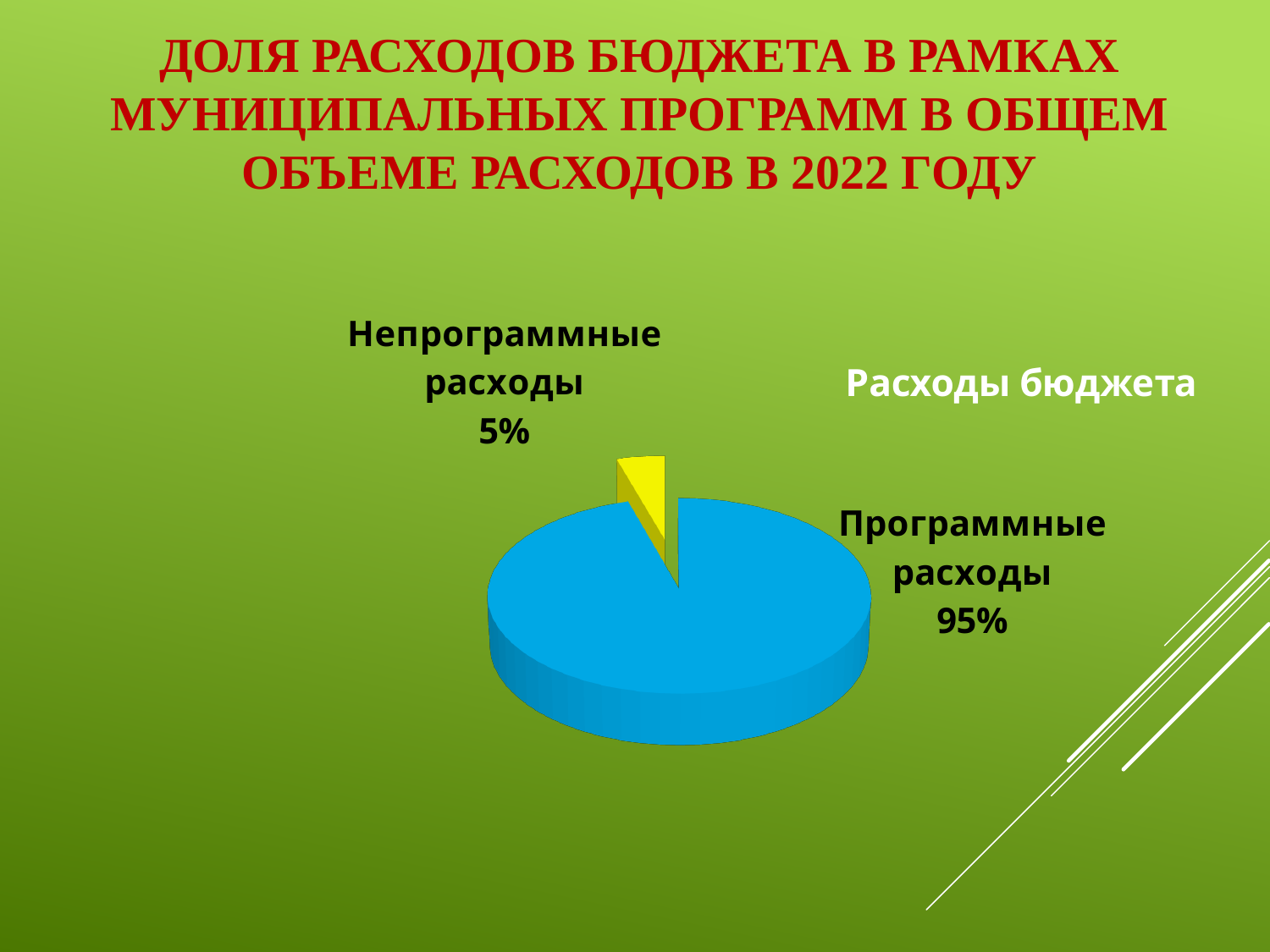
What is the title of the pie chart? Расходы бюджета Which slice of the pie is the smallest? Непрограммные расходы Which slice of the pie is the largest? Программные расходы Which is larger, Программные расходы or Непрограммные расходы? Программные расходы What kind of chart is shown on the slide? pie chart What colour is the Непрограммные расходы slice? yellow What is the difference in percentage points between Программные расходы and Непрограммные расходы? 90 What share of the pie is Программные расходы? 95% How many slices does the pie chart have? 2 What share of the pie is Непрограммные расходы? 5%